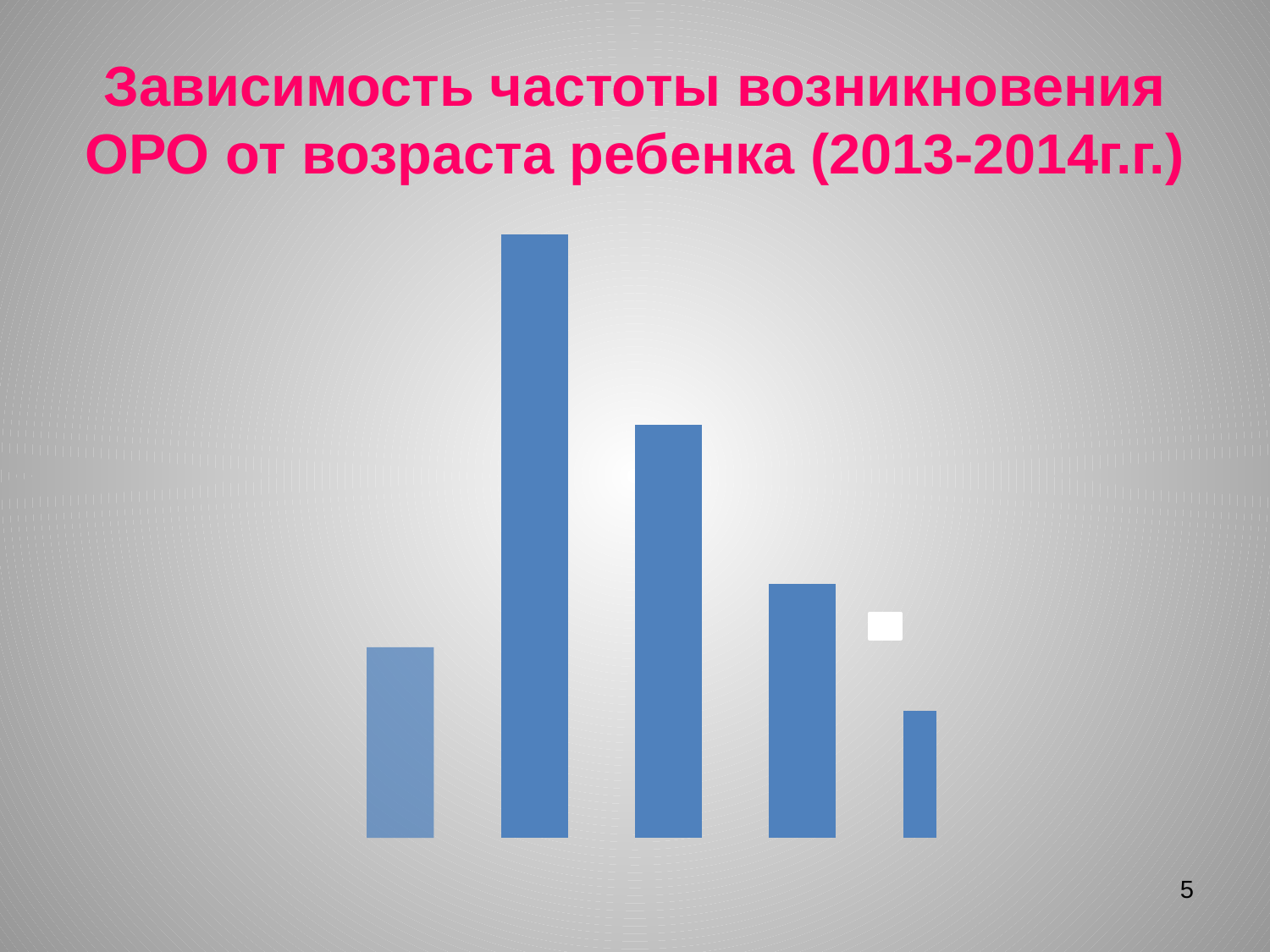
What kind of chart is shown on the slide? bar chart How many bars are plotted in the chart? 5 Which is taller, the third bar from the left or the fourth bar from the left? the third bar from the left Which bar in the chart is the tallest? the second bar from the left Which is taller, the leftmost bar or the rightmost bar? the leftmost bar What colour are the bars in the chart? blue Do the bar heights rise or fall from the second bar to the fifth bar? fall Which bar in the chart is the shortest? the rightmost bar What is the title of the slide containing the chart? Зависимость частоты возникновения ОРО от возраста ребенка (2013-2014г.г.)